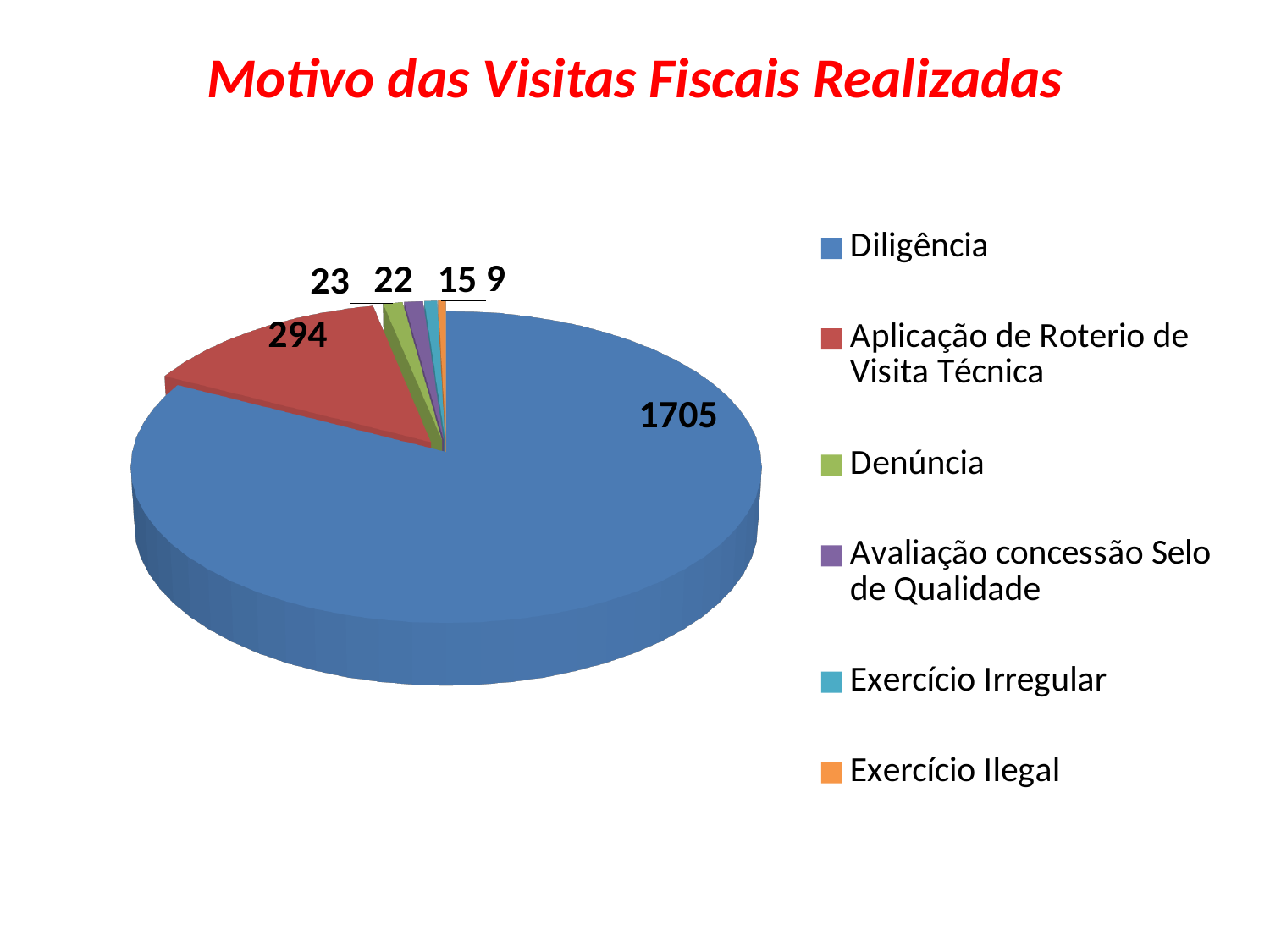
What is the value for Exercício Irregular? 15 What is the title of the chart? Motivo das Visitas Fiscais Realizadas What is the difference between the values for Diligência and Aplicação de Roterio de Visita Técnica? 1411 Which is larger, the value for Aplicação de Roterio de Visita Técnica or the value for Denúncia? Aplicação de Roterio de Visita Técnica What type of chart is shown on the slide? pie chart Which category has the largest slice of the pie? Diligência Which category has the smallest slice of the pie? Exercício Ilegal What is the value for Diligência? 1705 How many categories does the pie chart have? 6 What is the value for Exercício Ilegal? 9 What is the value for Aplicação de Roterio de Visita Técnica? 294 What is the difference between the values for Denúncia and Avaliação concessão Selo de Qualidade? 1